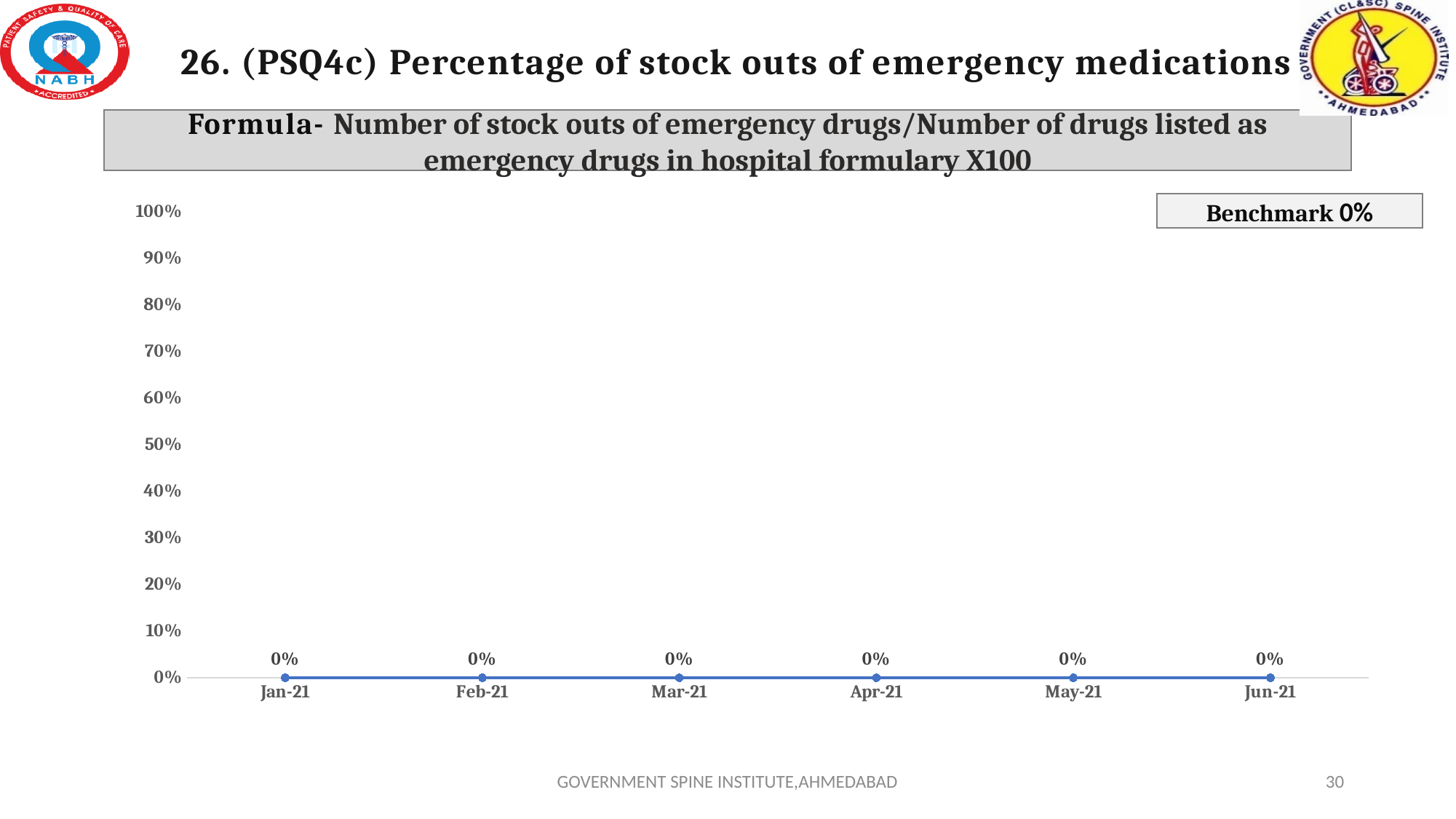
What is the highest value shown on the vertical axis? 100% What kind of chart is shown on the slide? line chart Do the values rise, fall, or stay flat from Jan-21 to Jun-21? stay flat What is the value for Jun-21? 0% What is the value for Mar-21? 0% Which month is the first category on the x axis? Jan-21 What is the value for Jan-21? 0% What benchmark value is shown on the slide? 0% Is the value for May-21 greater or less than 10%? less How many months are plotted on the chart? 6 What is the difference between the values for Feb-21 and May-21? 0% What is the value for Apr-21? 0%